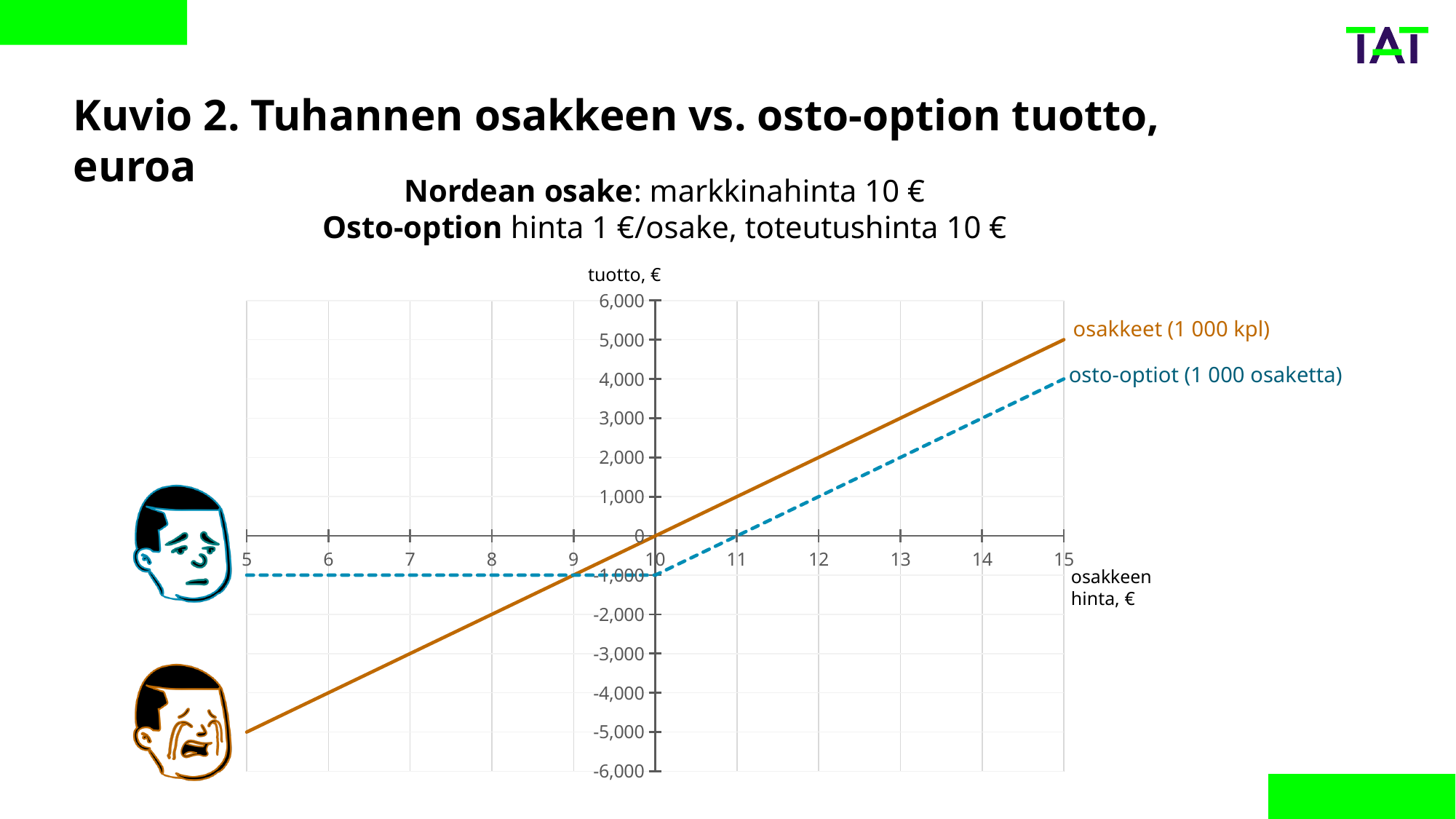
Is the tuotto for osakkeet (1 000 kpl) at an osakkeen hinta of 13 € greater or less than 2,000? greater What is the tuotto for osto-optiot (1 000 osaketta) when the osakkeen hinta is 15 €? 4,000 How many series does the chart show? 2 What is the difference between the tuotto of osakkeet (1 000 kpl) and osto-optiot (1 000 osaketta) at an osakkeen hinta of 15 €? 1,000 What is the tuotto for osakkeet (1 000 kpl) when the osakkeen hinta is 5 €? -5,000 What is the label of the vertical axis of the chart? tuotto, € Does the tuotto for osakkeet (1 000 kpl) rise or fall as the osakkeen hinta increases from 5 € to 15 €? rise What is the tuotto for osakkeet (1 000 kpl) when the osakkeen hinta is 15 €? 5,000 What is the tuotto for osakkeet (1 000 kpl) when the osakkeen hinta is 10 €? 0 At an osakkeen hinta of 5 €, which series has the higher tuotto, osakkeet (1 000 kpl) or osto-optiot (1 000 osaketta)? osto-optiot (1 000 osaketta) What is the tuotto for osto-optiot (1 000 osaketta) when the osakkeen hinta is 5 €? -1,000 What kind of chart is shown on the slide? line chart